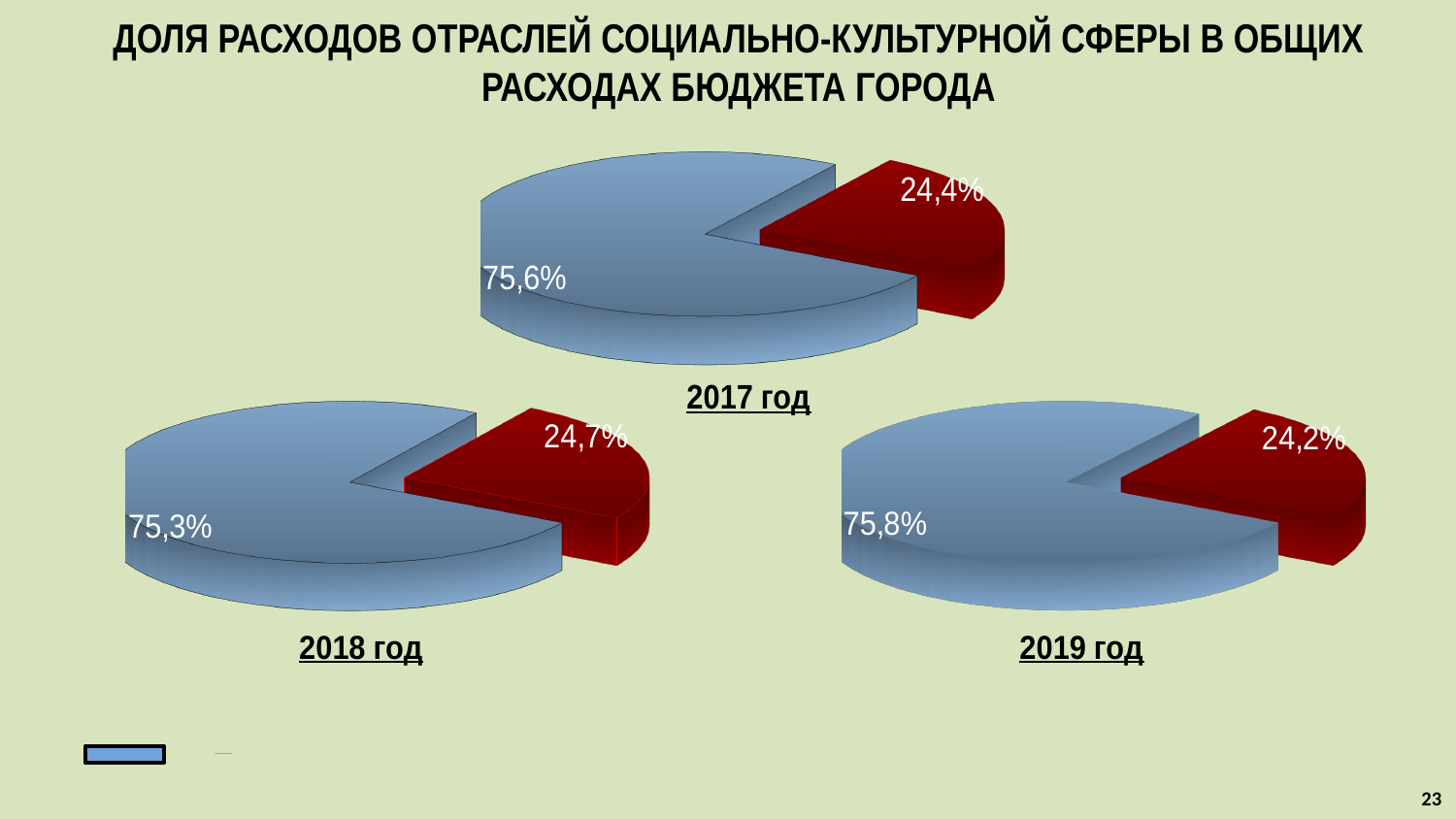
Across the three pie charts, in which year is the red slice smallest? 2019 год In the 2017 год pie chart, what value is shown for the blue slice? 75,6% Across the three pie charts, in which year is the red slice largest? 2018 год What kind of chart is used for each year on this slide? Pie chart In the 2018 год pie chart, what value is shown for the blue slice? 75,3% In the 2018 год pie chart, what value is shown for the red slice? 24,7% In the 2019 год pie chart, what value is shown for the blue slice? 75,8% How many slices does the 2017 год pie chart have? 2 How many pie charts are shown on the slide? 3 In the 2017 год pie chart, what is the difference between the blue slice and the red slice? 51,2% In the 2017 год pie chart, what value is shown for the red slice? 24,4% In the 2019 год pie chart, what value is shown for the red slice? 24,2%